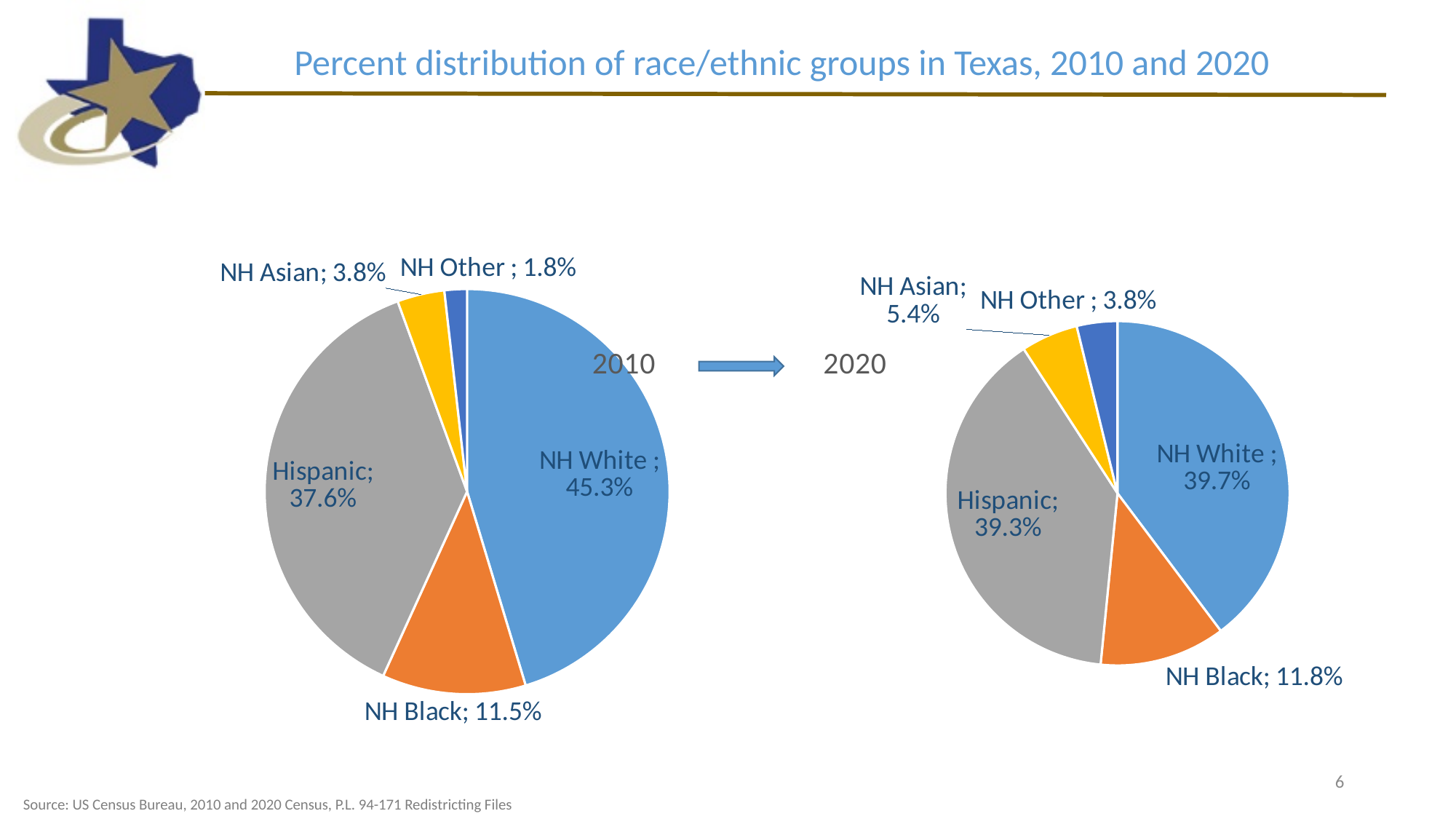
In the 2010 pie chart, which group has the largest share? NH White What is the difference between the NH White share in 2010 and in 2020? 5.6% What is the difference between the Hispanic share in 2020 and in 2010? 1.7% What is the title of the slide's charts? Percent distribution of race/ethnic groups in Texas, 2010 and 2020 In the 2020 pie chart, what is the value for NH Asian? 5.4% In the 2010 pie chart, what is the value for NH White? 45.3% How many slices does the 2010 pie chart have? 5 In the 2020 pie chart, which is larger: NH Black or NH Asian? NH Black In the 2020 pie chart, what is the value for Hispanic? 39.3% In the 2020 pie chart, which group has the smallest share? NH Other In the 2010 pie chart, what is the value for NH Other? 1.8% What kind of chart is used on this slide? Pie chart